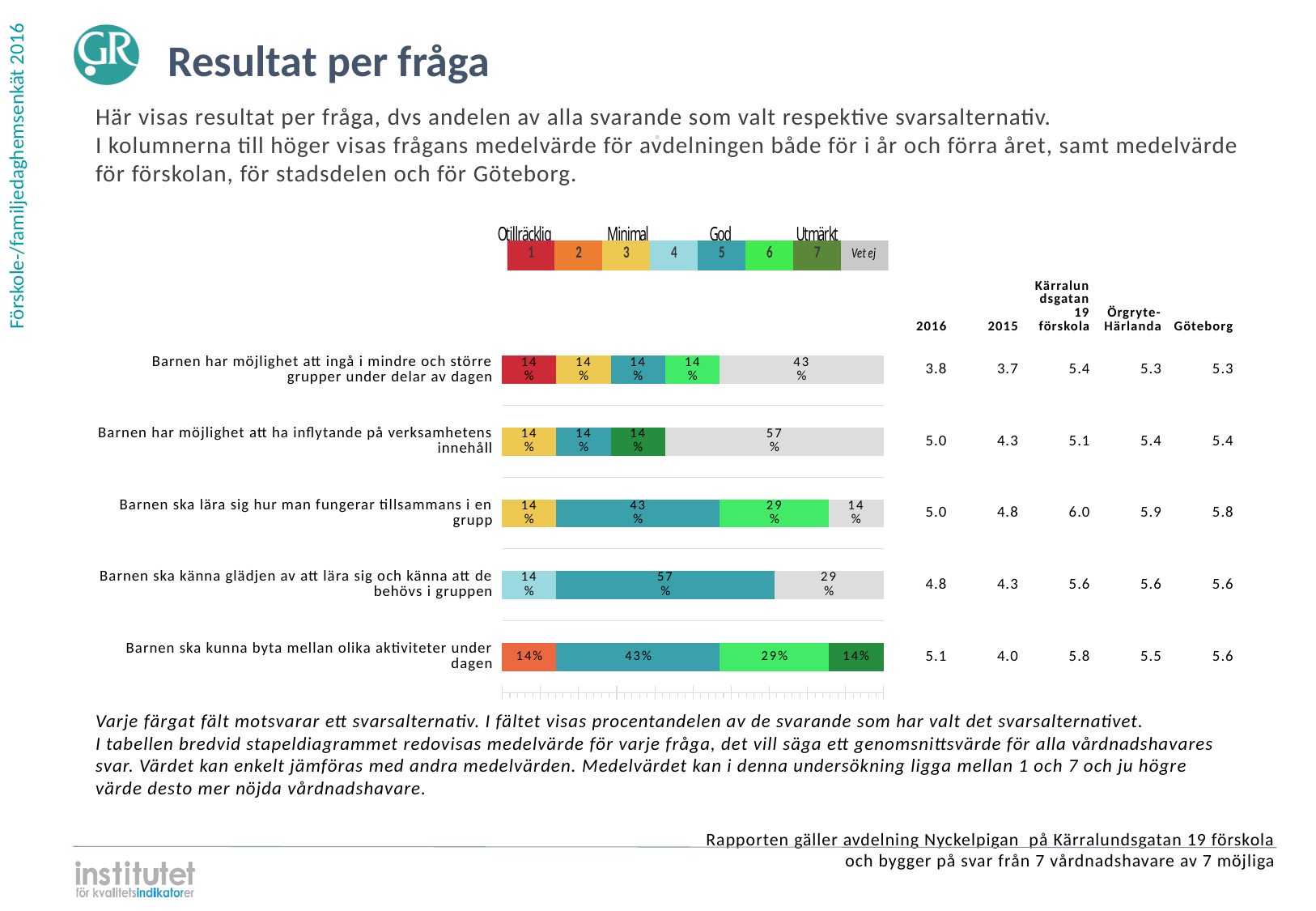
What percentage of respondents chose answer 5 for 'Barnen ska kunna byta mellan olika aktiviteter under dagen'? 43% What kind of chart is shown on the slide? Stacked bar chart How many answer categories does the legend above the chart list? 8 For 'Barnen ska känna glädjen av att lära sig och känna att de behövs i gruppen', which is larger: the share for answer 5 or the share for 'Vet ej'? Answer 5 What is the 2016 mean value shown for 'Barnen ska kunna byta mellan olika aktiviteter under dagen'? 5.1 Which label in the legend corresponds to answer values 1 and 2? Otillräcklig What percentage of respondents answered 'Vet ej' for 'Barnen har möjlighet att ingå i mindre och större grupper under delar av dagen'? 43% What percentage of respondents answered 'Vet ej' for 'Barnen har möjlighet att ha inflytande på verksamhetens innehåll'? 57% What is the difference between the 'Vet ej' share for 'Barnen har möjlighet att ha inflytande på verksamhetens innehåll' (57%) and for 'Barnen ska lära sig hur man fungerar tillsammans i en grupp' (14%)? 43% How many questions (bars) are plotted in the chart? 5 What is the total of the segments in the bar for 'Barnen ska kunna byta mellan olika aktiviteter under dagen' (14%, 43%, 29%, 14%)? 100% Which question has the largest 'Vet ej' share? Barnen har möjlighet att ha inflytande på verksamhetens innehåll